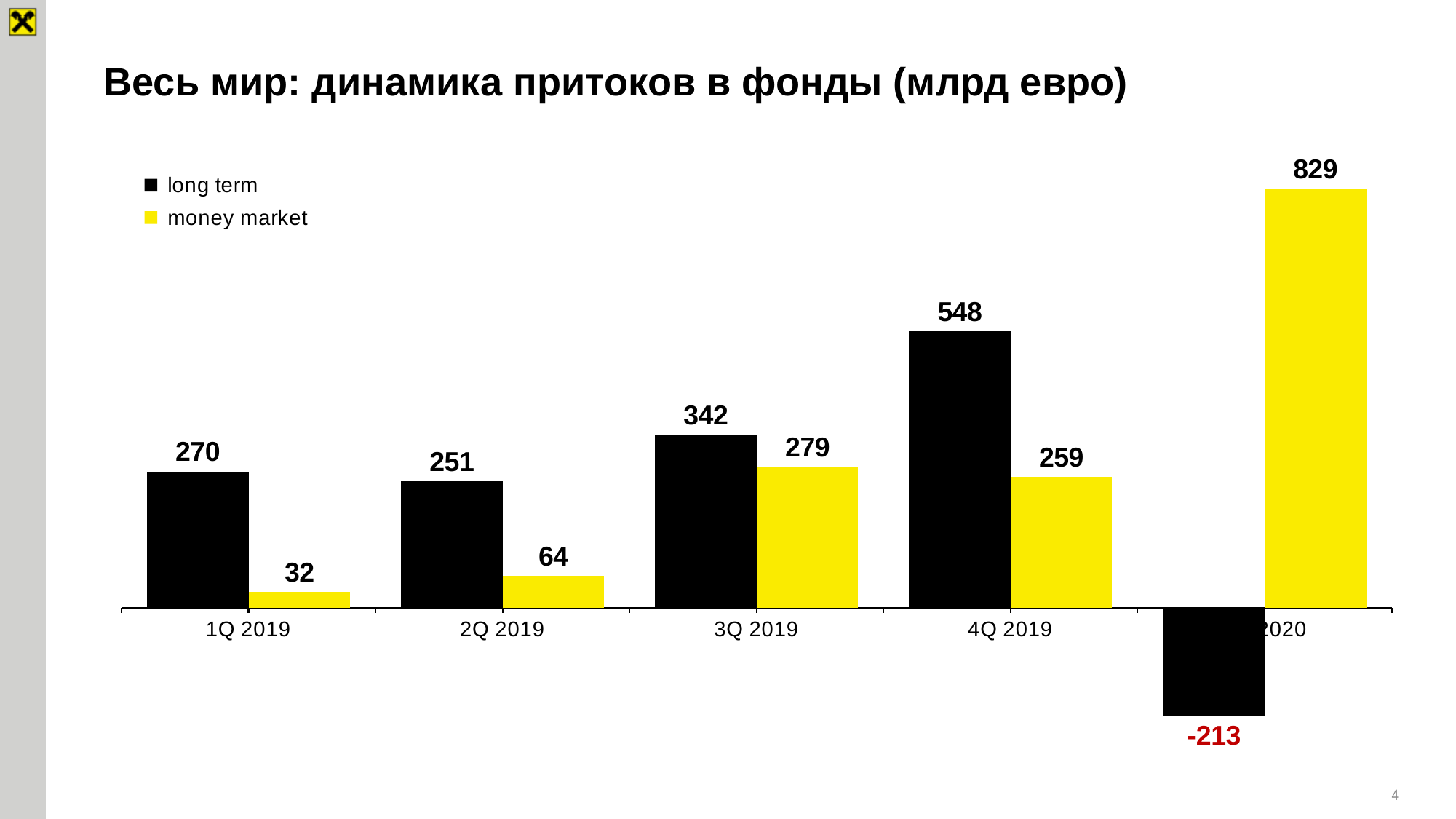
What is the difference between the long term and money market values in 4Q 2019? 289 Among the 2019 quarters, which has the highest long term value? 4Q 2019 What is the long term value for the rightmost (2020) category? -213 What is the long term value for 4Q 2019? 548 How many categories are shown on the x axis? 5 What is the long term value for 1Q 2019? 270 What kind of chart is shown on the slide? bar chart How many series does the legend list? 2 Which category has the lowest money market value? 1Q 2019 What is the money market value for 3Q 2019? 279 In 3Q 2019, which is larger: long term or money market? long term What colour represents the money market series? yellow